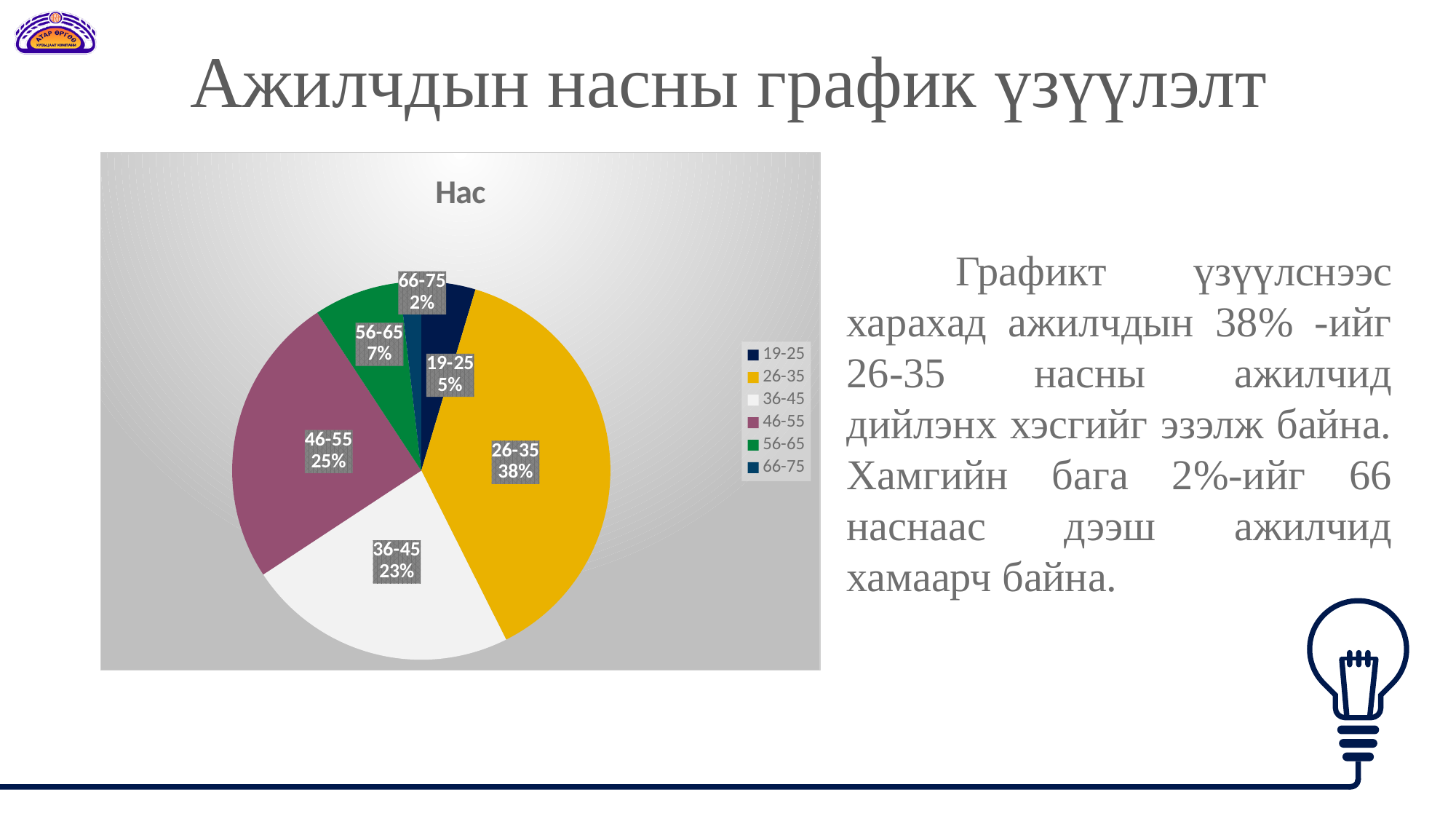
What is the value shown for the 36-45 age group? 23% What share of the pie does the 26-35 age group hold? 38% What colour is the slice for the 46-55 age group? purple Which age group has the largest share of the pie? 26-35 Which age group has the smallest share of the pie? 66-75 Which is larger, the share for 19-25 or the share for 56-65? 56-65 How many age groups are shown in the pie chart? 6 What is the value shown for the 46-55 age group? 25% What is the title of the chart? Нас What is the value shown for the 56-65 age group? 7% What kind of chart is shown on the slide? pie chart What is the difference between the shares of the 26-35 and 36-45 age groups? 15%